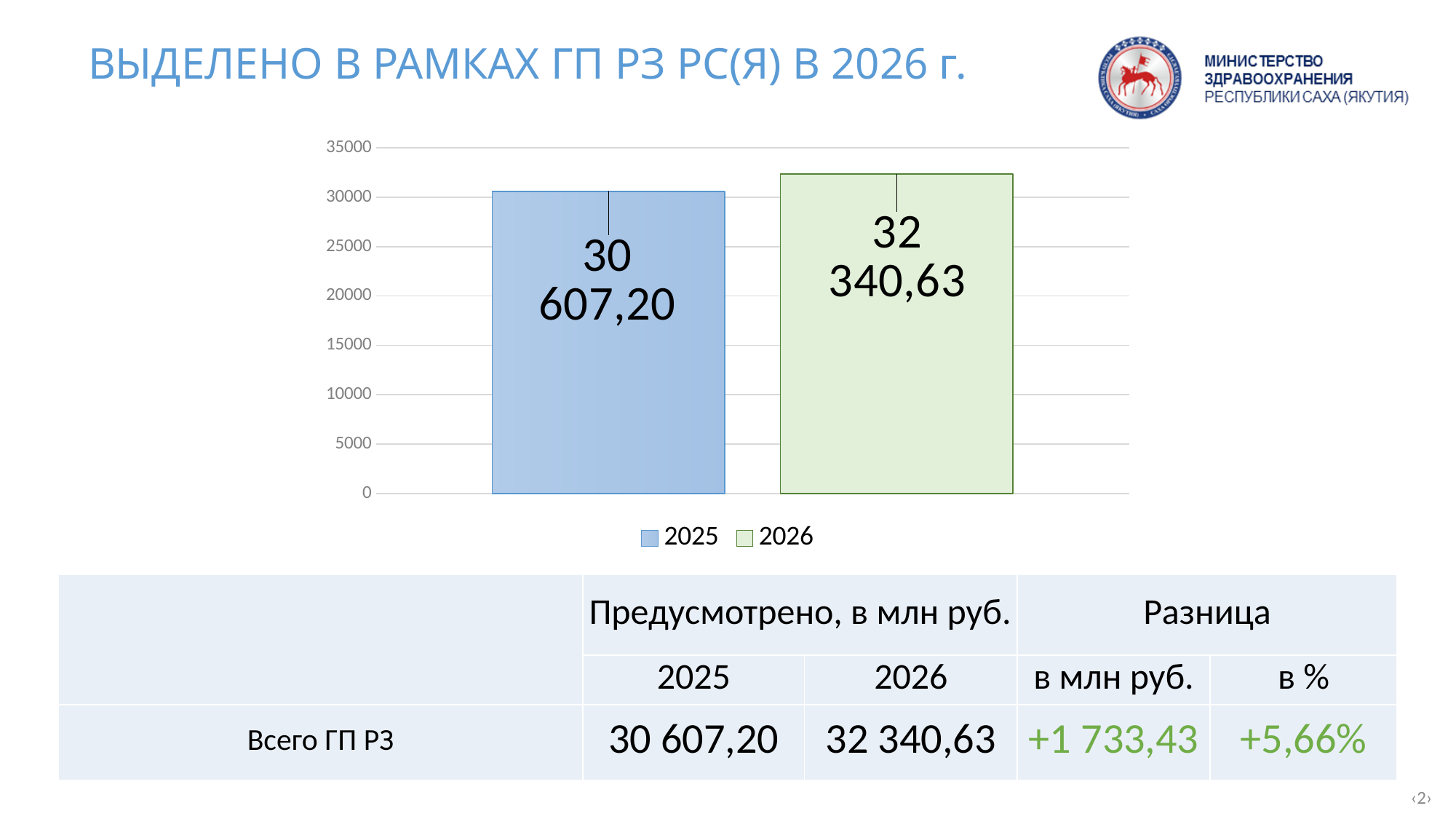
Is the value for 2025 greater or less than 30000? greater Is the value for 2026 greater or less than 35000? less What colour is the 2026 bar? green What is the value of the 2025 bar? 30 607,20 Which year has the lower bar? 2025 What is the value of the 2026 bar? 32 340,63 What type of chart is shown on the slide? bar chart How many bars are plotted in the chart? 2 What is the difference between the 2026 and 2025 values? 1 733,43 Which year has the higher bar? 2026 Is the value for 2025 larger or smaller than the value for 2026? smaller How many entries does the legend list? 2